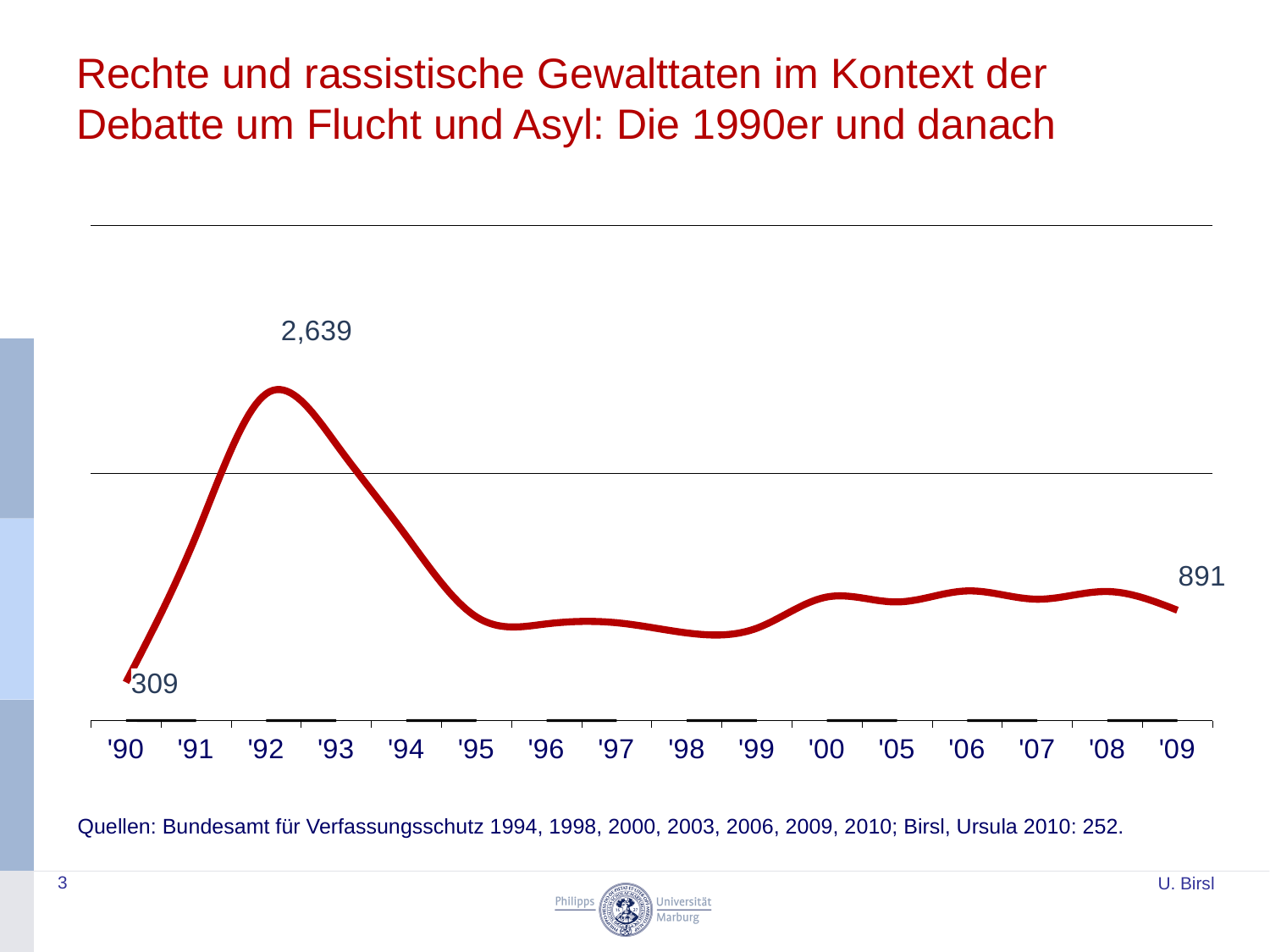
What is the value for '90? 309 How many years are labelled on the x axis? 16 Which year has the highest value? '92 Which year has the lowest value? '90 Do the values rise or fall from '92 to '95? fall What is the difference between the values for '09 and '90? 582 What kind of chart is shown on the slide? line chart What is the value for '92? 2,639 What is the difference between the values for '92 and '90? 2,330 What is the value for '09? 891 Do the values rise or fall from '90 to '92? rise Which is larger, the value for '92 or the value for '09? '92